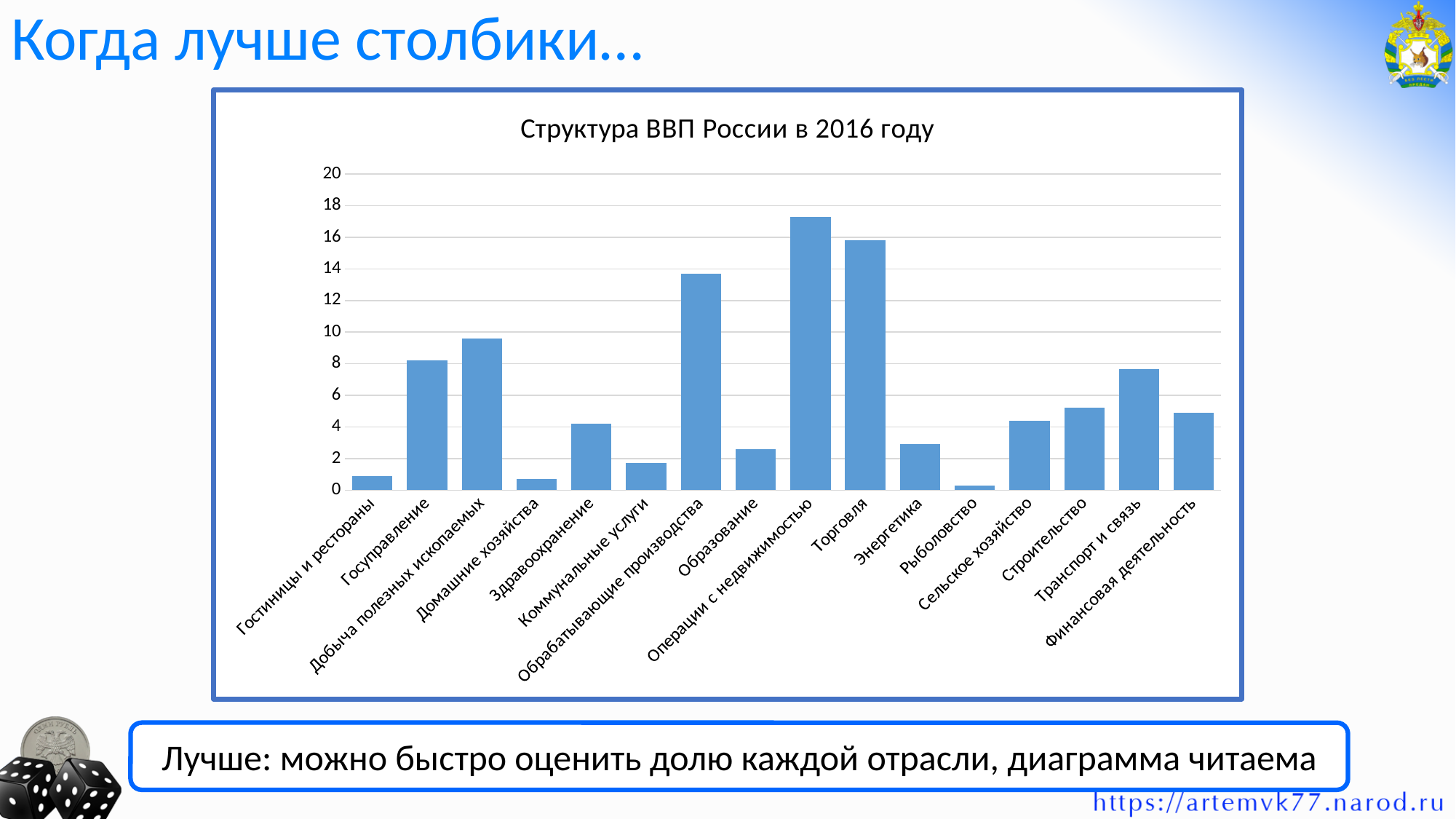
Is the value for Строительство greater or less than 4? greater Which is larger, the value for Добыча полезных ископаемых or the value for Госуправление? Добыча полезных ископаемых How many categories (industries) are shown on the x axis of the chart? 16 Which category has the highest value in the chart? Операции с недвижимостью Is the value for Транспорт и связь greater or less than 8? less Is the value for Операции с недвижимостью greater or less than 16? greater Which category has the lowest value in the chart? Рыболовство Which is larger, the value for Торговля or the value for Обрабатывающие производства? Торговля What is the title of the chart? Структура ВВП России в 2016 году What kind of chart is shown on the slide? bar chart